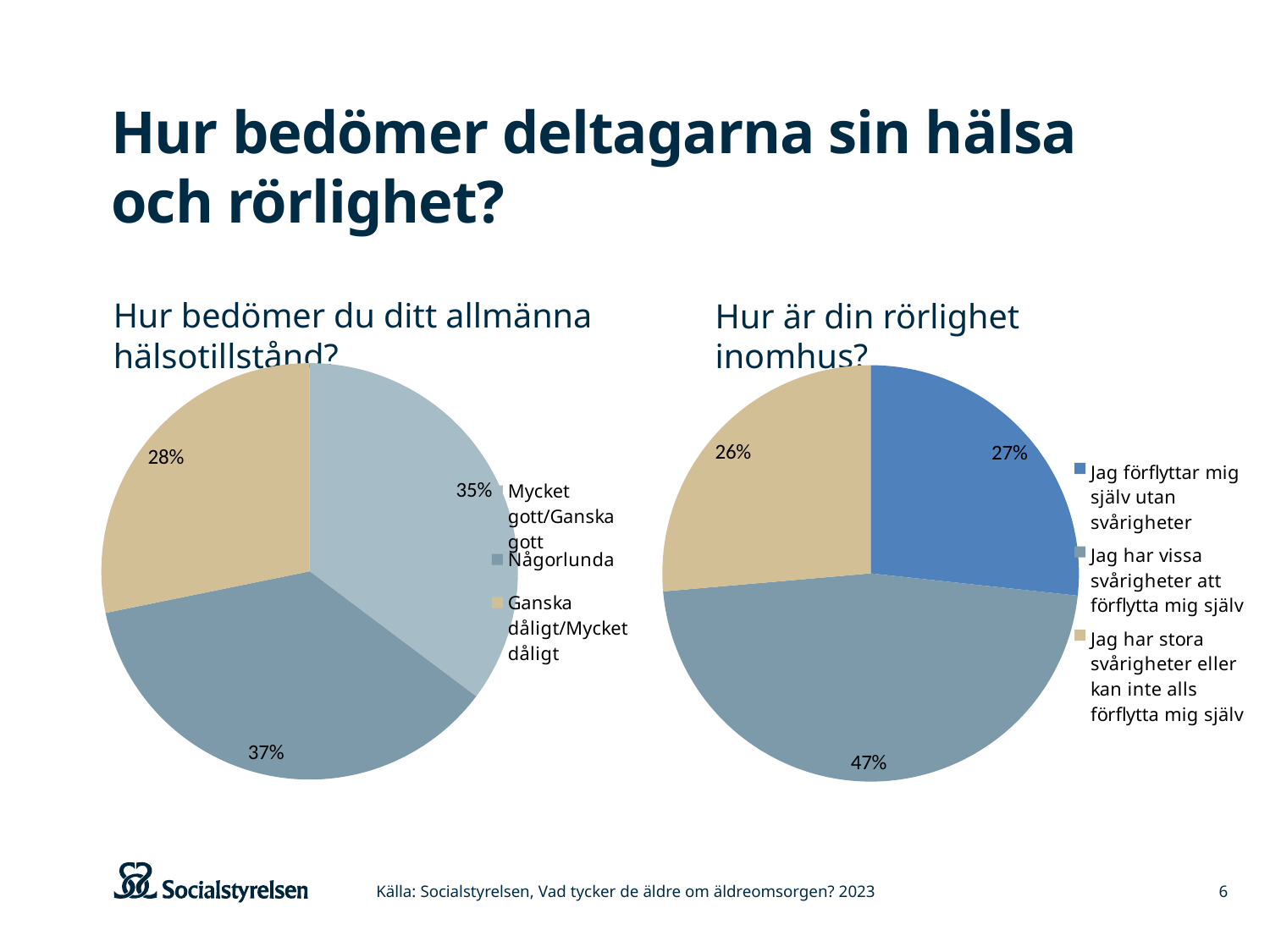
How many categories does the legend of the chart 'Hur är din rörlighet inomhus?' list? 3 In the chart 'Hur bedömer du ditt allmänna hälsotillstånd?', what colour is the 'Ganska dåligt/Mycket dåligt' slice? Tan/beige In the chart 'Hur bedömer du ditt allmänna hälsotillstånd?', what share of respondents answered 'Någorlunda'? 37% In the chart 'Hur bedömer du ditt allmänna hälsotillstånd?', what share of respondents answered 'Ganska dåligt/Mycket dåligt'? 28% In the chart 'Hur bedömer du ditt allmänna hälsotillstånd?', what share of respondents answered 'Mycket gott/Ganska gott'? 35% In the chart 'Hur är din rörlighet inomhus?', what is the difference in percentage points between 'Jag har vissa svårigheter att förflytta mig själv' and 'Jag har stora svårigheter eller kan inte alls förflytta mig själv'? 21 percentage points What type of chart is used for 'Hur är din rörlighet inomhus?'? Pie chart In the chart 'Hur bedömer du ditt allmänna hälsotillstånd?', which category has the smallest slice? Ganska dåligt/Mycket dåligt In the chart 'Hur är din rörlighet inomhus?', which category has the largest slice? Jag har vissa svårigheter att förflytta mig själv In the chart 'Hur är din rörlighet inomhus?', what share of respondents answered 'Jag har vissa svårigheter att förflytta mig själv'? 47% In the chart 'Hur bedömer du ditt allmänna hälsotillstånd?', what is the difference in percentage points between 'Någorlunda' and 'Ganska dåligt/Mycket dåligt'? 9 percentage points In the chart 'Hur är din rörlighet inomhus?', what share of respondents answered 'Jag förflyttar mig själv utan svårigheter'? 27%